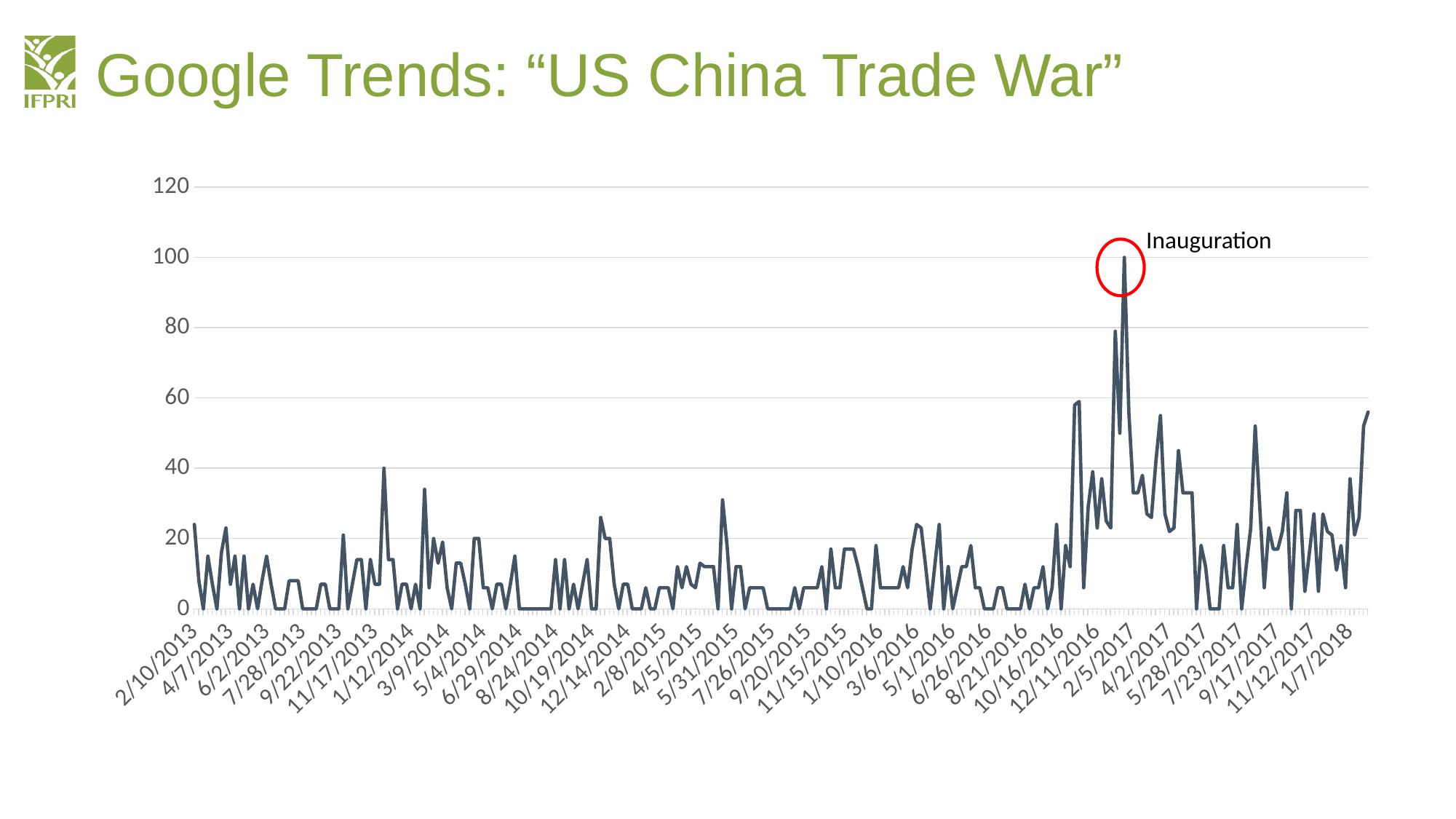
What kind of chart is shown on the slide? line chart Is the value at the highest peak greater or less than 80? greater Is the value at the final point on the right end of the line greater or less than 40? greater What event is annotated at the circled peak of the line? Inauguration Is the peak near 11/17/2013 greater or less than 60? less How many lines (series) are plotted on the chart? 1 Which is larger: the peak near 11/17/2013 or the peak near 2/5/2017? the peak near 2/5/2017 What is the title of the chart? Google Trends: "US China Trade War" Overall, do the values tend to rise or fall from 2013 to 2018? rise Which x-axis date label is closest to the highest peak of the line? 2/5/2017 What value does the line reach at its highest peak, marked 'Inauguration'? 100